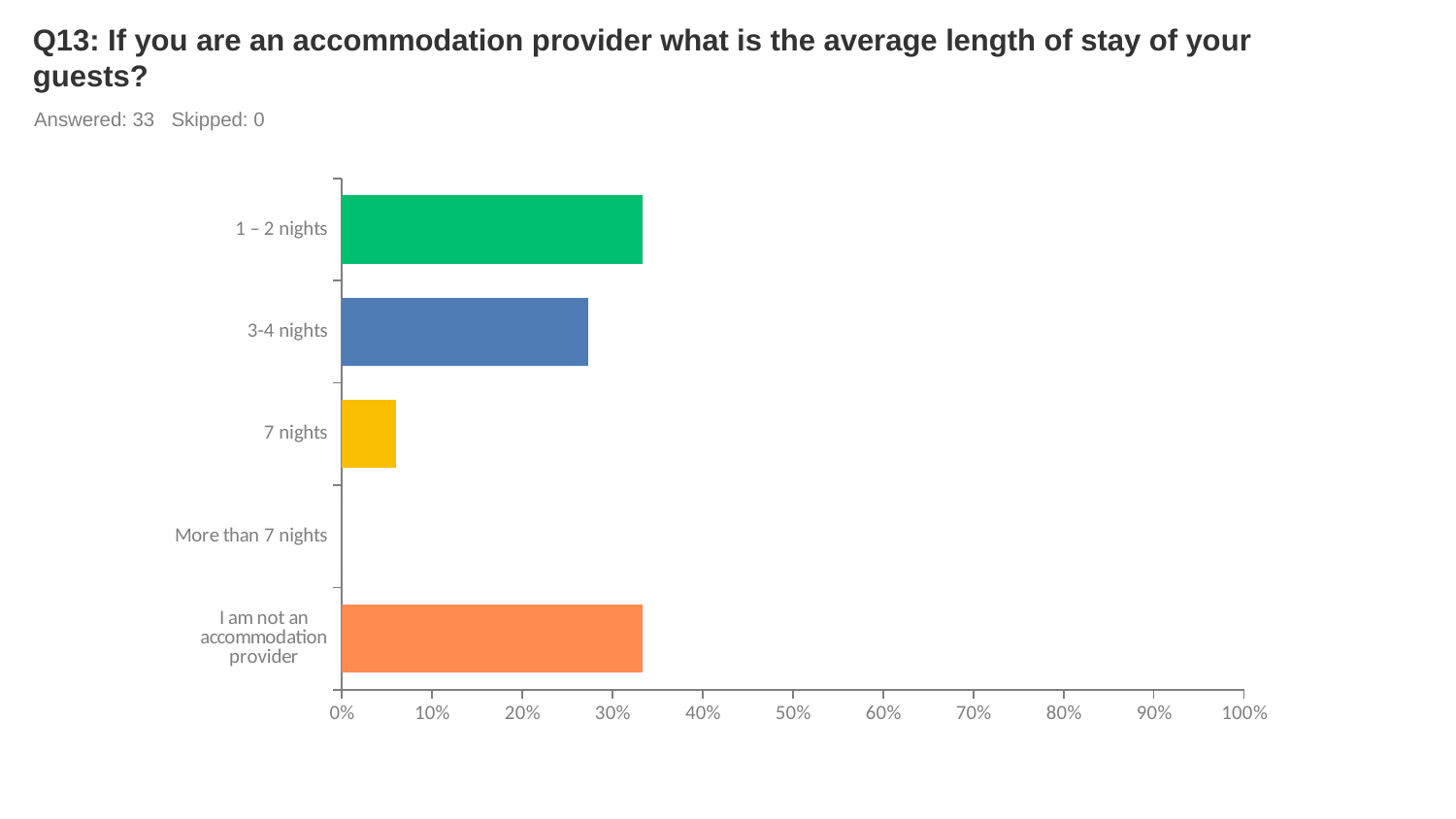
Which category has the lowest value? More than 7 nights Which is larger, the value for 7 nights or the value for More than 7 nights? 7 nights How many categories are shown on the chart? 5 Is the value for 'I am not an accommodation provider' greater or less than 30%? greater Is the value for 3-4 nights greater or less than 30%? less What colour is the bar for 7 nights? yellow What kind of chart is shown on the slide? bar chart Which is larger, the value for 1 – 2 nights or the value for 3-4 nights? 1 – 2 nights Which is larger, the value for 3-4 nights or the value for 7 nights? 3-4 nights How many respondents answered this question according to the slide? 33 Is the value for 7 nights greater or less than 10%? less